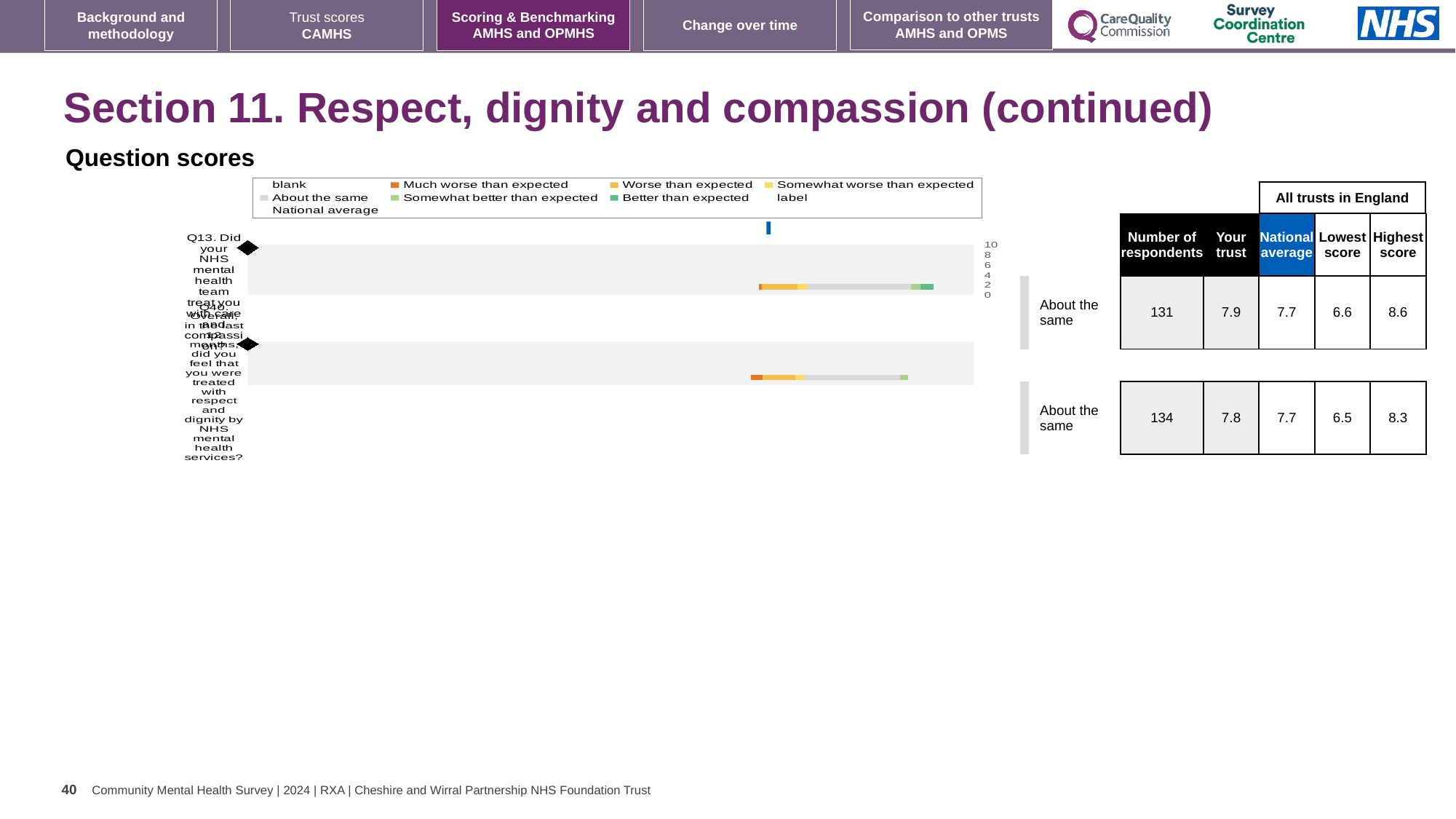
What is the 'Your trust' score for Q10 in the table next to the chart? 7.8 What kind of chart is used to show the question scores on this slide? bar chart Which question has more respondents, Q13 or Q10? Q10 How many respondents are listed for Q13? 131 What is the lowest score across all trusts in England for Q10? 6.5 What is the 'Your trust' score for Q13 in the table next to the chart? 7.9 By how much does the trust's score for Q13 exceed the national average? 0.2 What is the highest score across all trusts in England for Q13? 8.6 How many entries does the legend of the question scores chart list? 9 What benchmark category is shown for Q13 next to the chart? About the same How many questions are plotted in the question scores chart? 2 What is the national average score for Q10? 7.7